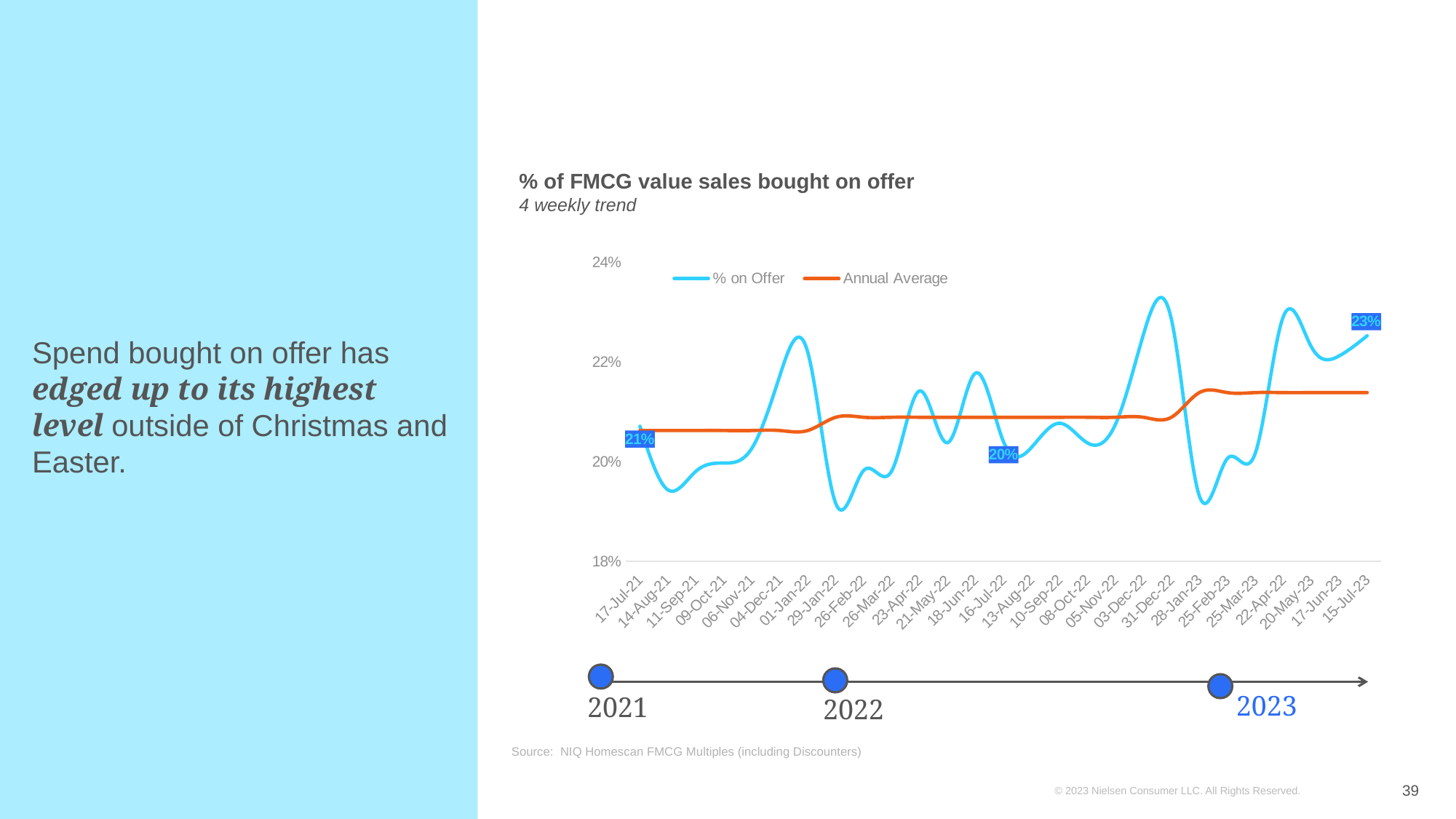
What is the % on Offer value labelled at 15-Jul-23? 23% By how many percentage points does the labelled % on Offer value at 15-Jul-23 exceed the labelled value at 16-Jul-22? 3 percentage points What is the % on Offer value labelled at 17-Jul-21? 21% How many series does the chart's legend list? 2 Does the Annual Average line rise or fall from the start to the end of the period shown? rise What kind of chart is shown on the slide? line chart What is the title of the chart? % of FMCG value sales bought on offer Is the % on Offer value at 31-Dec-22 greater or less than 22%? greater What are the two series named in the chart's legend? % on Offer and Annual Average Is the % on Offer value at 29-Jan-22 greater or less than 20%? less What is the % on Offer value labelled at 16-Jul-22? 20% Which has the higher labelled % on Offer value, 17-Jul-21 or 15-Jul-23? 15-Jul-23